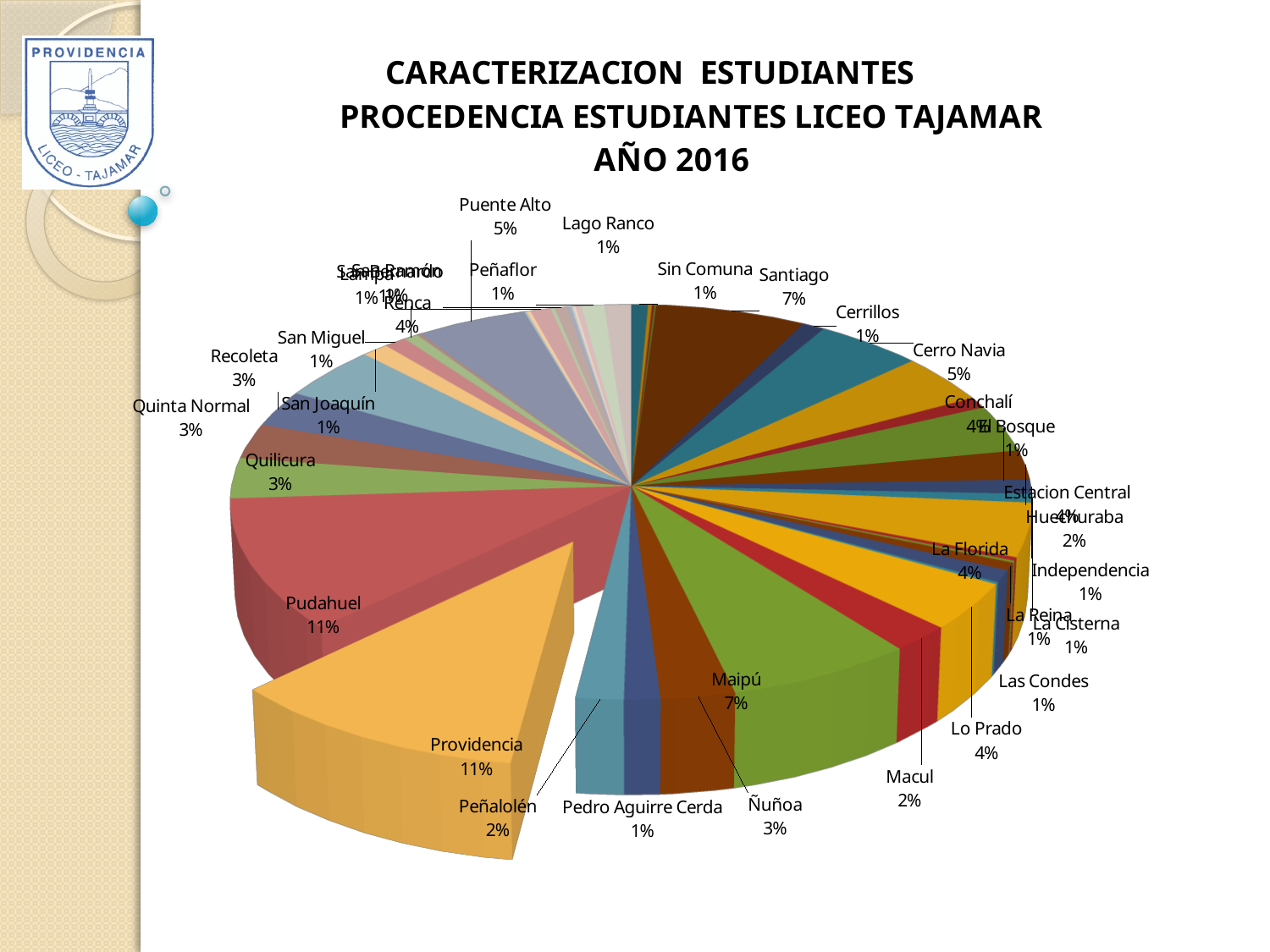
What is the difference in percentage points between Santiago and Ñuñoa? 4 What percentage is shown for Cerro Navia? 5% Which year does the chart title refer to? 2016 What percentage is shown for Puente Alto? 5% What percentage is shown for Santiago? 7% What percentage is shown for Lo Prado? 4% Which has a larger share, Cerro Navia or Macul? Cerro Navia What share of students comes from Pudahuel? 11% What share of students comes from Providencia? 11% What type of chart is shown on the slide? pie chart Which has a larger share, Pudahuel or Maipú? Pudahuel What percentage is shown for Maipú? 7%